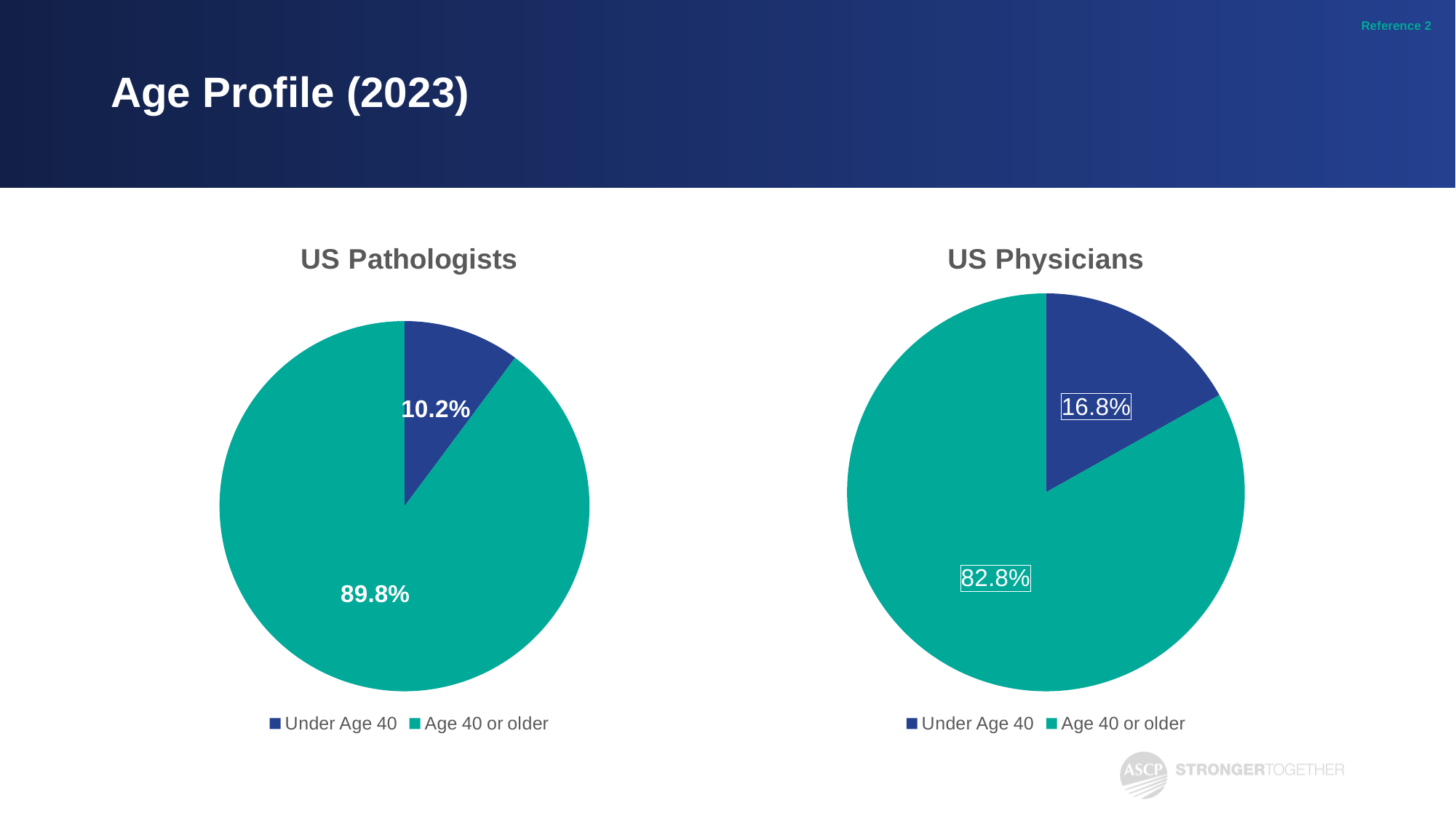
What type of chart is the US Physicians chart? Pie chart In the US Pathologists chart, what percentage of pathologists are under age 40? 10.2% In the US Pathologists chart, what is the difference between the share age 40 or older and the share under age 40? 79.6% In the US Pathologists chart, which category has the largest share? Age 40 or older In the US Physicians chart, what percentage of physicians are age 40 or older? 82.8% In the US Physicians chart, which category has the smallest share? Under Age 40 Comparing the two charts, which group has the larger share under age 40: US Pathologists or US Physicians? US Physicians In the US Physicians chart, what percentage of physicians are under age 40? 16.8% In the US Physicians chart, which colour represents the Under Age 40 category? Dark blue In the US Pathologists chart, what percentage of pathologists are age 40 or older? 89.8% What is the difference between the under-age-40 share in the US Physicians chart and the under-age-40 share in the US Pathologists chart? 6.6% How many categories does the legend of the US Pathologists chart list? 2